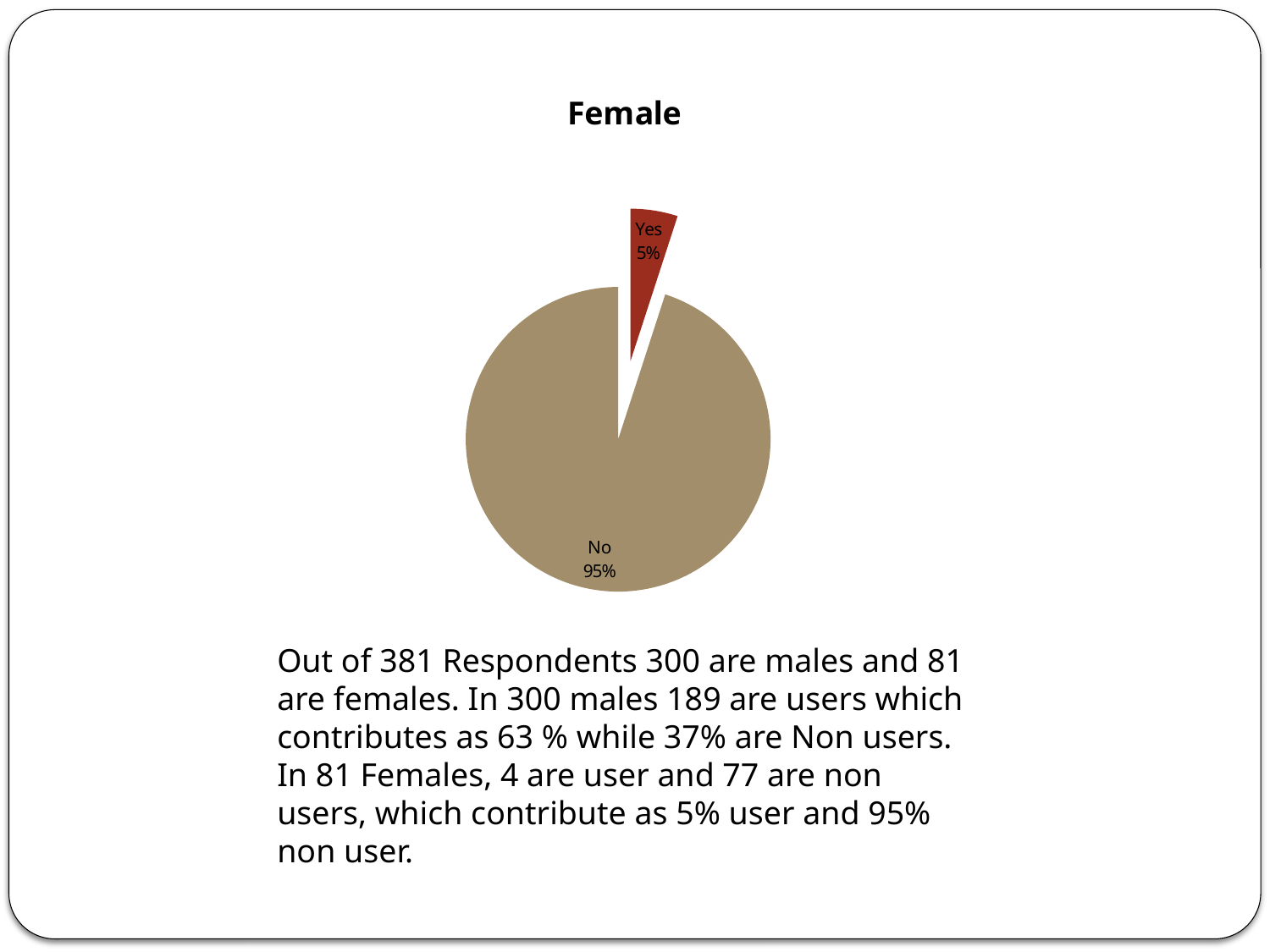
What colour is the "Yes" slice? red Which slice is the largest in the pie chart? No Which slice is larger, "Yes" or "No"? No What is the title of the pie chart? Female Which slice is the smallest in the pie chart? Yes What is the difference in percentage points between the "No" and "Yes" slices? 90 How many slices does the pie chart have? 2 What kind of chart is shown on the slide? pie chart What percentage does the "Yes" slice represent? 5% What percentage does the "No" slice represent? 95% What share of the pie does the "No" slice take? 95%